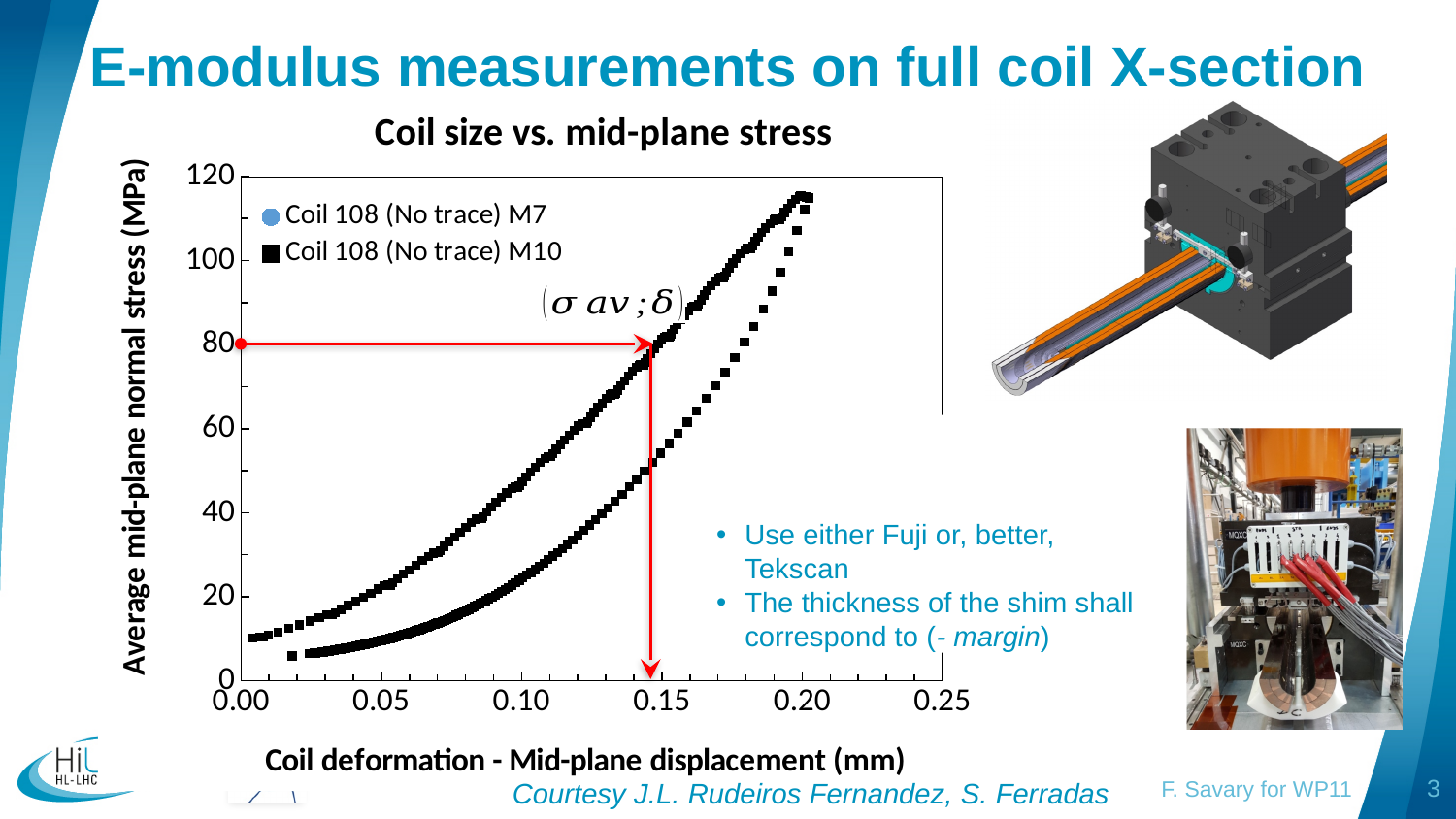
What stress value on the y axis does the horizontal red arrow start from? 80 What kind of chart is shown on the slide? Scatter chart What is the highest value shown on the y axis of the chart? 120 What is the highest value shown on the x axis of the chart? 0.25 What is the title of the chart? Coil size vs. mid-plane stress Does the mid-plane normal stress rise or fall as the mid-plane displacement increases along the x axis? Rise Is the largest mid-plane displacement reached by the plotted data greater or less than 0.25 mm? less How many series does the chart legend list? 2 At a displacement of 0.05 mm, is the stress of the upper curve greater or less than 40 MPa? less What is the label of the y axis of the chart? Average mid-plane normal stress (MPa) Is the maximum stress reached by the plotted data greater or less than 100 MPa? greater